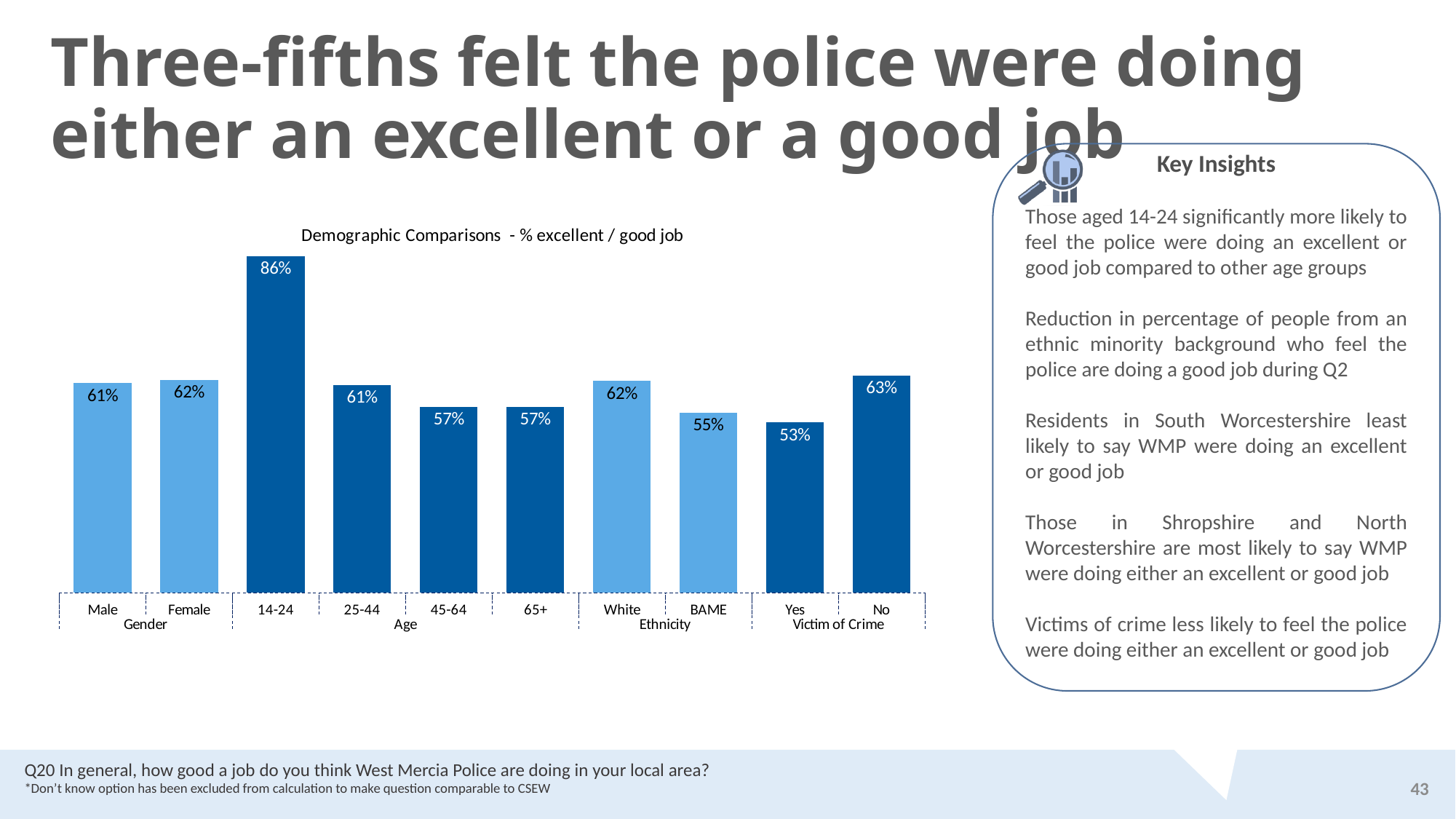
How many bars are plotted in the chart? 10 Which category has the highest value in the chart? 14-24 What type of chart is shown on the slide? Bar chart What percentage of the 14-24 age group felt the police were doing an excellent or good job? 86% Which category has the lowest value in the chart? Yes (Victim of Crime) What is the difference in percentage points between the 14-24 and 25-44 age groups? 25 Which is larger, the value for victims of crime (Yes) or non-victims (No)? No What is the title of the chart? Demographic Comparisons - % excellent / good job What is the value shown for BAME respondents? 55% What is the value shown for respondents who were a victim of crime (Yes)? 53% What is the difference in percentage points between White and BAME respondents? 7 How many demographic groupings are labelled along the x axis? 4